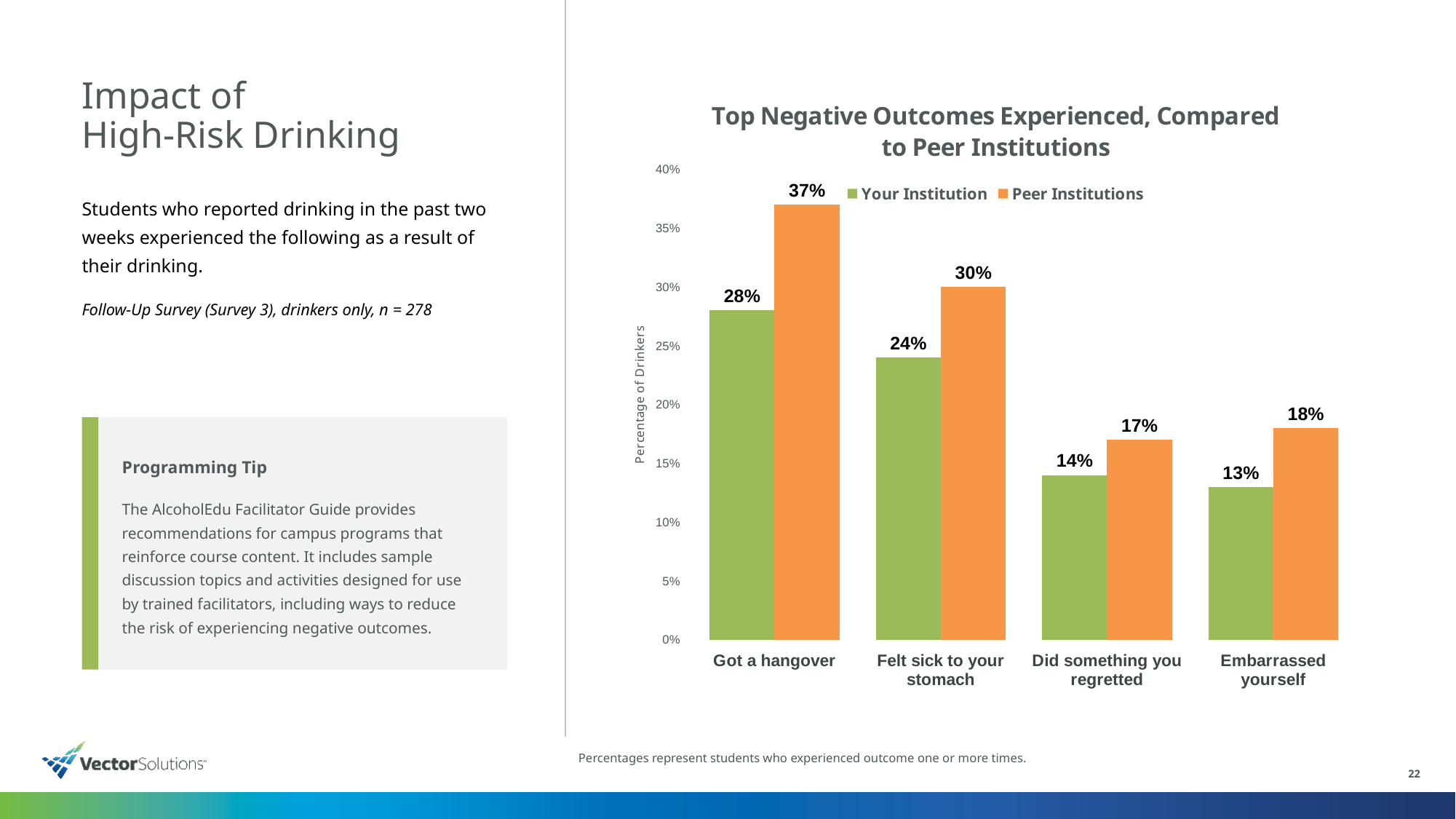
What kind of chart is shown on the slide? Bar chart What is the value for Your Institution for "Embarrassed yourself"? 13% What is the difference between Peer Institutions and Your Institution for "Got a hangover"? 9% What is the value for Your Institution for "Got a hangover"? 28% How many series does the legend list? 2 Which category has the lowest value for Your Institution? Embarrassed yourself What is the value for Peer Institutions for "Felt sick to your stomach"? 30% Which is larger for "Did something you regretted": Your Institution or Peer Institutions? Peer Institutions How many outcome categories are shown on the x axis? 4 Which category has the highest value for Peer Institutions? Got a hangover Do the Your Institution values rise or fall from "Got a hangover" to "Embarrassed yourself"? Fall What is the title of the chart? Top Negative Outcomes Experienced, Compared to Peer Institutions